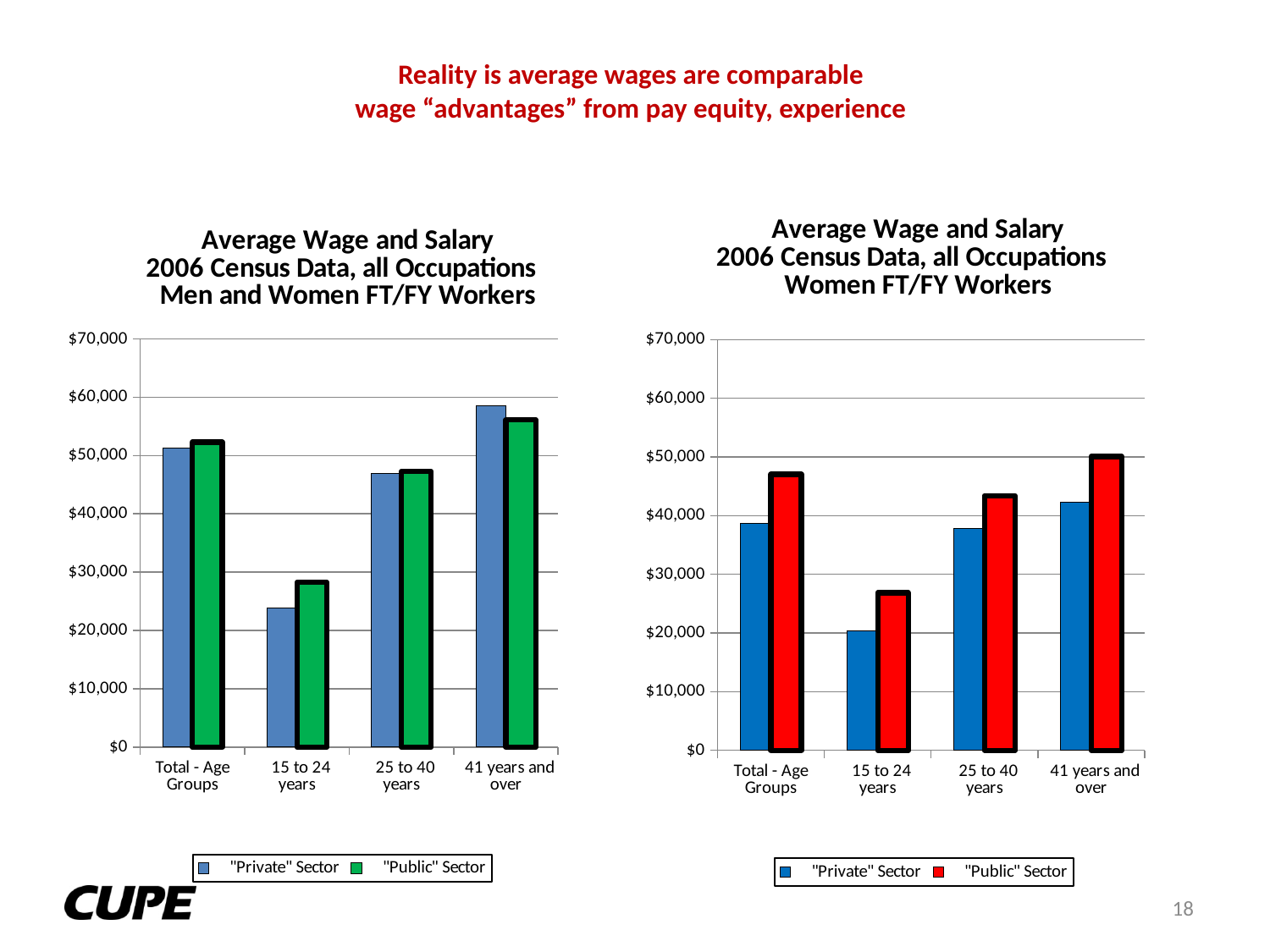
In the right chart (Women FT/FY Workers), for Total - Age Groups, which is larger: the "Private" Sector or the "Public" Sector value? "Public" Sector In the left chart (Men and Women FT/FY Workers), is the "Private" Sector value for 15 to 24 years greater or less than $30,000? less In the left chart (Men and Women FT/FY Workers), which age group has the lowest "Private" Sector average wage? 15 to 24 years What kind of chart is the right chart (Women FT/FY Workers)? bar chart In the right chart (Women FT/FY Workers), which age group has the highest "Public" Sector average wage? 41 years and over In the left chart (Men and Women FT/FY Workers), which age group has the highest "Private" Sector average wage? 41 years and over In the right chart (Women FT/FY Workers), is the "Public" Sector value for 15 to 24 years greater or less than $30,000? less In the left chart (Men and Women FT/FY Workers), for 41 years and over, which is larger: the "Private" Sector or the "Public" Sector value? "Private" Sector How many series does the legend of the left chart (Men and Women FT/FY Workers) list? 2 How many age-group categories are shown on the x axis of the right chart (Women FT/FY Workers)? 4 In the left chart (Men and Women FT/FY Workers), is the "Private" Sector value for 41 years and over greater or less than $50,000? greater